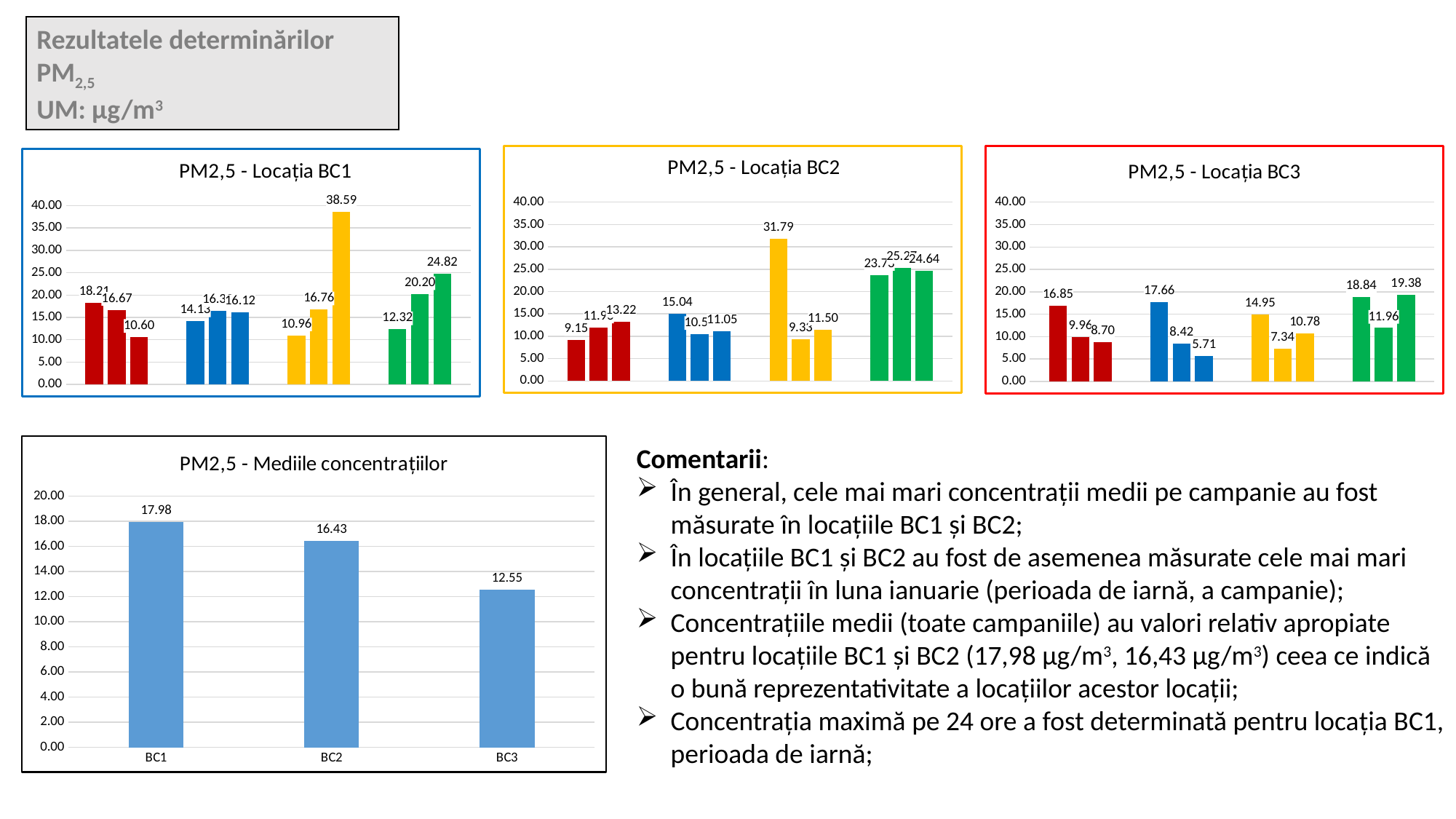
In the 'PM2,5 - Mediile concentrațiilor' chart, what is the value for BC3? 12.55 In the 'PM2,5 - Locația BC3' chart, what is the lowest value labeled? 5.71 In the 'PM2,5 - Mediile concentrațiilor' chart, what is the value for BC2? 16.43 In the 'PM2,5 - Mediile concentrațiilor' chart, how many locations are shown on the x axis? 3 In the 'PM2,5 - Mediile concentrațiilor' chart, what is the difference between the values for BC1 and BC3? 5.43 In the 'PM2,5 - Locația BC2' chart, what is the highest value labeled? 31.79 In the 'PM2,5 - Locația BC1' chart, what is the highest value labeled? 38.59 In the 'PM2,5 - Mediile concentrațiilor' chart, which location has the lowest value? BC3 What kind of chart is 'PM2,5 - Locația BC1'? bar chart In the 'PM2,5 - Mediile concentrațiilor' chart, which location has the highest value? BC1 In the 'PM2,5 - Mediile concentrațiilor' chart, what is the value for BC1? 17.98 In the 'PM2,5 - Mediile concentrațiilor' chart, do the values rise or fall from BC1 to BC3? fall